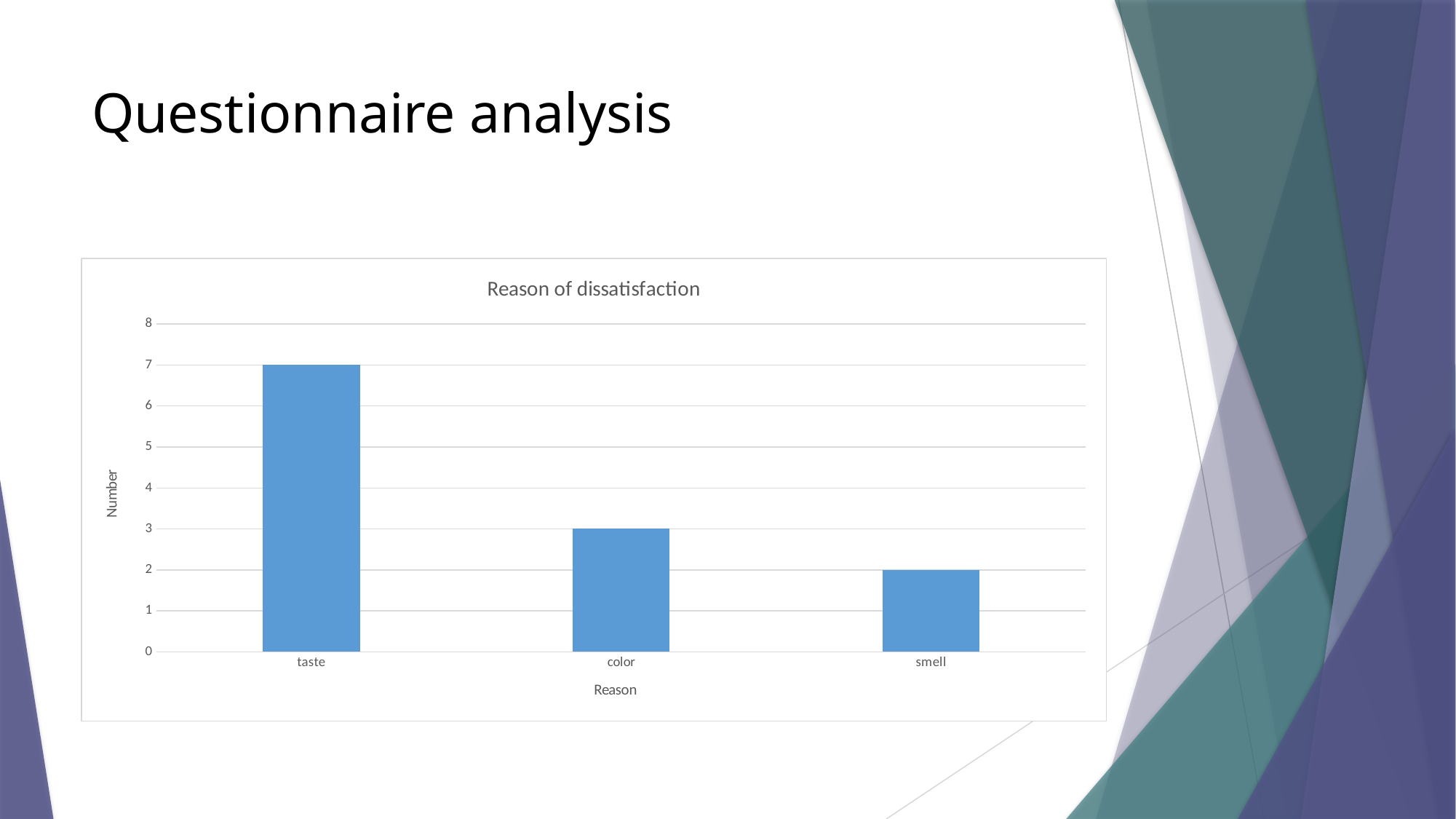
How many reasons are shown on the x axis? 3 Which reason has the lowest value? smell What is the difference between the values for taste and color? 4 Which reason has the highest value? taste Do the values rise or fall from taste to smell along the x axis? fall What is the value for color? 3 What kind of chart is this? bar chart Which is larger, the value for color or the value for smell? color Is the value for taste greater or less than 5? greater What is the value for taste? 7 What is the value for smell? 2 What is the title of the chart? Reason of dissatisfaction